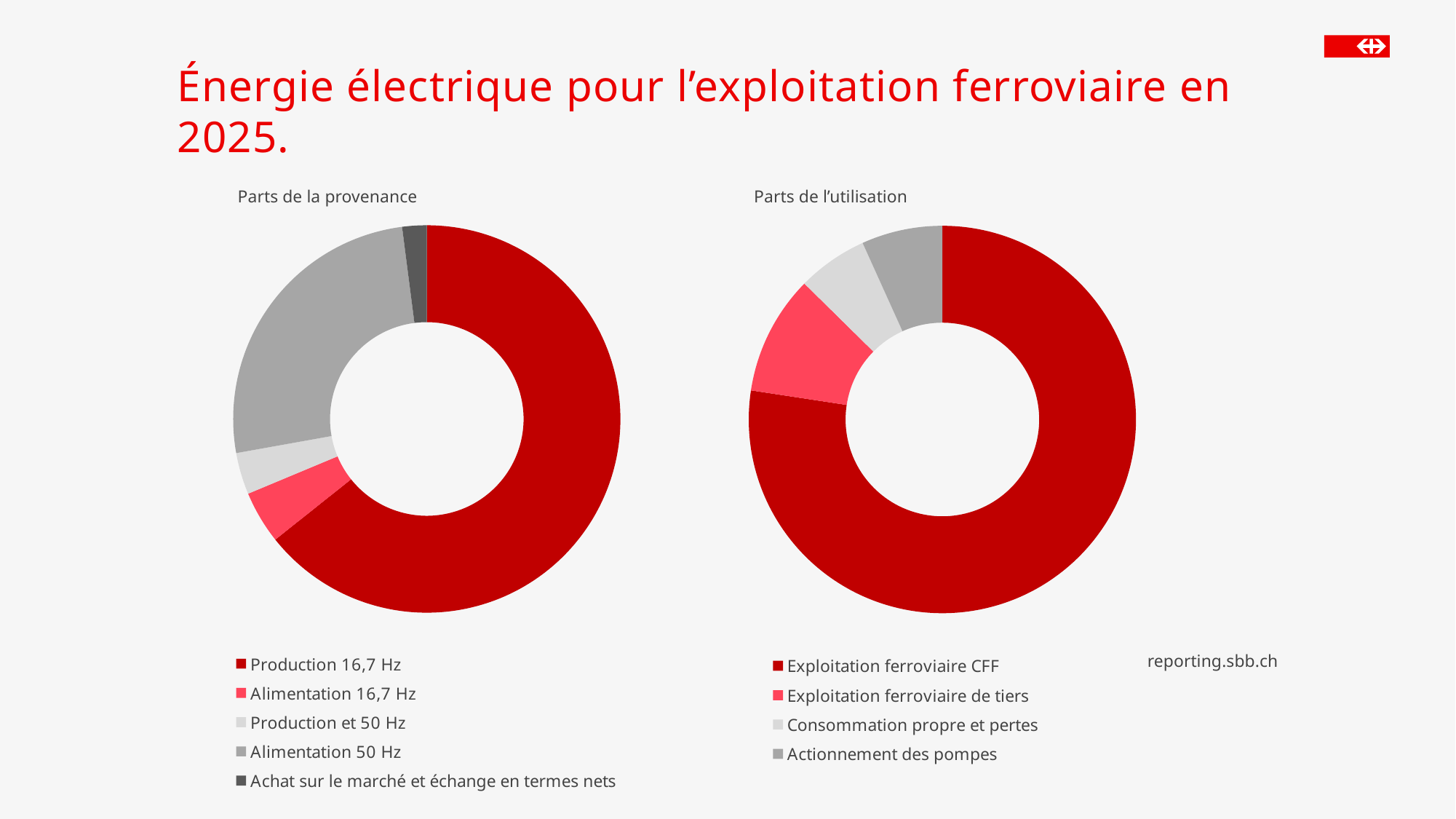
In the 'Parts de la provenance' chart, how many slices are there? 5 In the 'Parts de l’utilisation' chart, which category has the largest share? Exploitation ferroviaire CFF In the 'Parts de l’utilisation' chart, what colour is the slice for Exploitation ferroviaire de tiers? Pink What kind of chart is the 'Parts de l’utilisation' chart? Pie chart (donut) What kind of chart is the 'Parts de la provenance' chart? Pie chart (donut) In the 'Parts de l’utilisation' chart, how many slices are there? 4 In the 'Parts de la provenance' chart, which is larger: Alimentation 50 Hz or Alimentation 16,7 Hz? Alimentation 50 Hz What is the title of the slide? Énergie électrique pour l’exploitation ferroviaire en 2025. In the 'Parts de la provenance' chart, which category has the largest share? Production 16,7 Hz In the 'Parts de la provenance' chart, how many entries does the legend list? 5 In the 'Parts de l’utilisation' chart, which is larger: Exploitation ferroviaire CFF or Exploitation ferroviaire de tiers? Exploitation ferroviaire CFF In the 'Parts de la provenance' chart, which category has the smallest share? Achat sur le marché et échange en termes nets